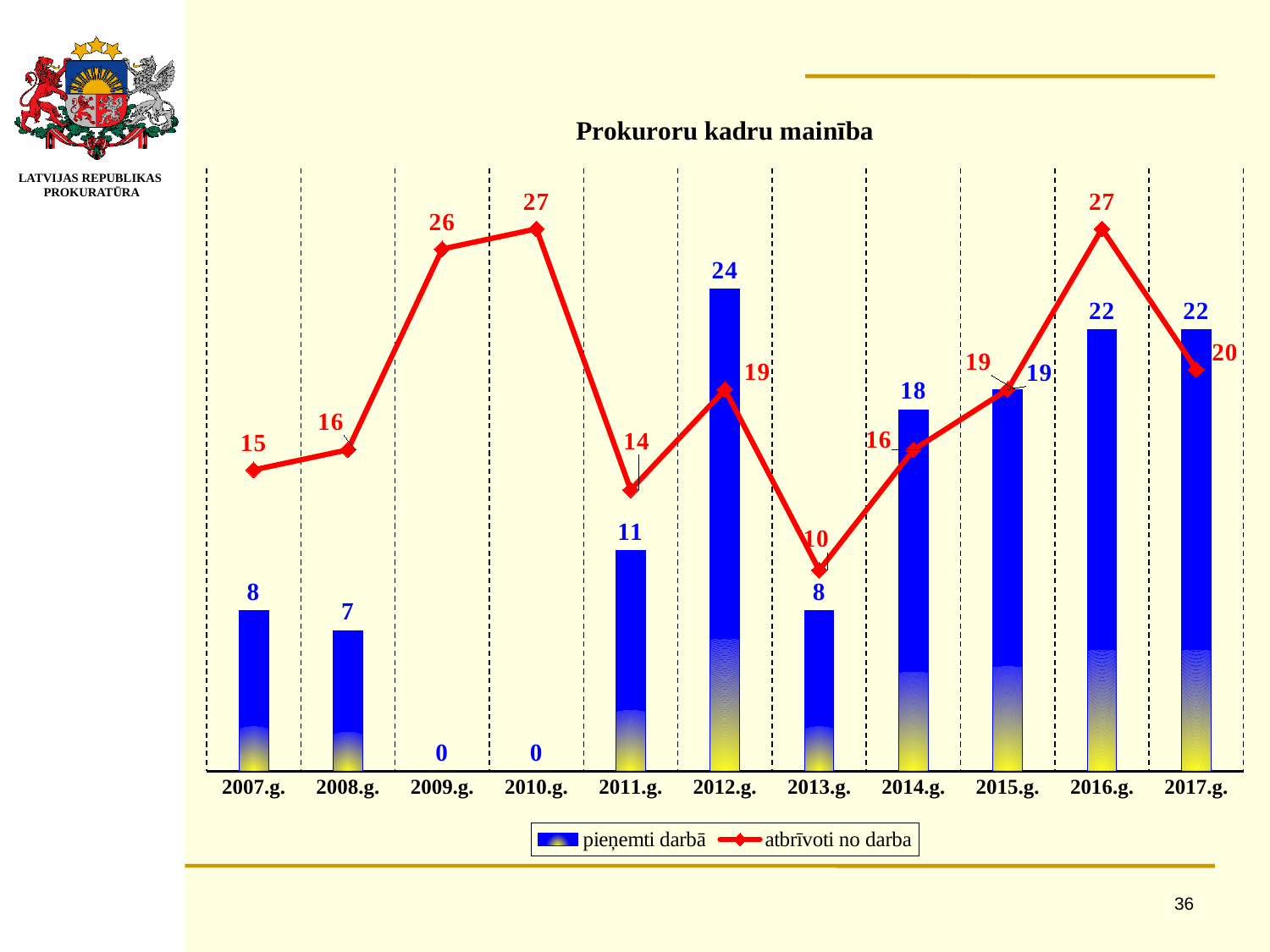
What is the value of 'atbrīvoti no darba' for 2017.g.? 20 In which year is 'pieņemti darbā' the highest? 2012.g. What is the value of 'atbrīvoti no darba' for 2009.g.? 26 How many series does the legend list? 2 What is the title of the chart? Prokuroru kadru mainība What is the value of 'pieņemti darbā' for 2012.g.? 24 What is the difference between 'pieņemti darbā' in 2012.g. and in 2013.g.? 16 What is the difference between 'atbrīvoti no darba' and 'pieņemti darbā' in 2010.g.? 27 Which is larger in 2012.g.: 'pieņemti darbā' or 'atbrīvoti no darba'? pieņemti darbā How many years are shown on the x axis? 11 In which year is 'atbrīvoti no darba' the lowest? 2013.g. What is the value of 'pieņemti darbā' for 2008.g.? 7